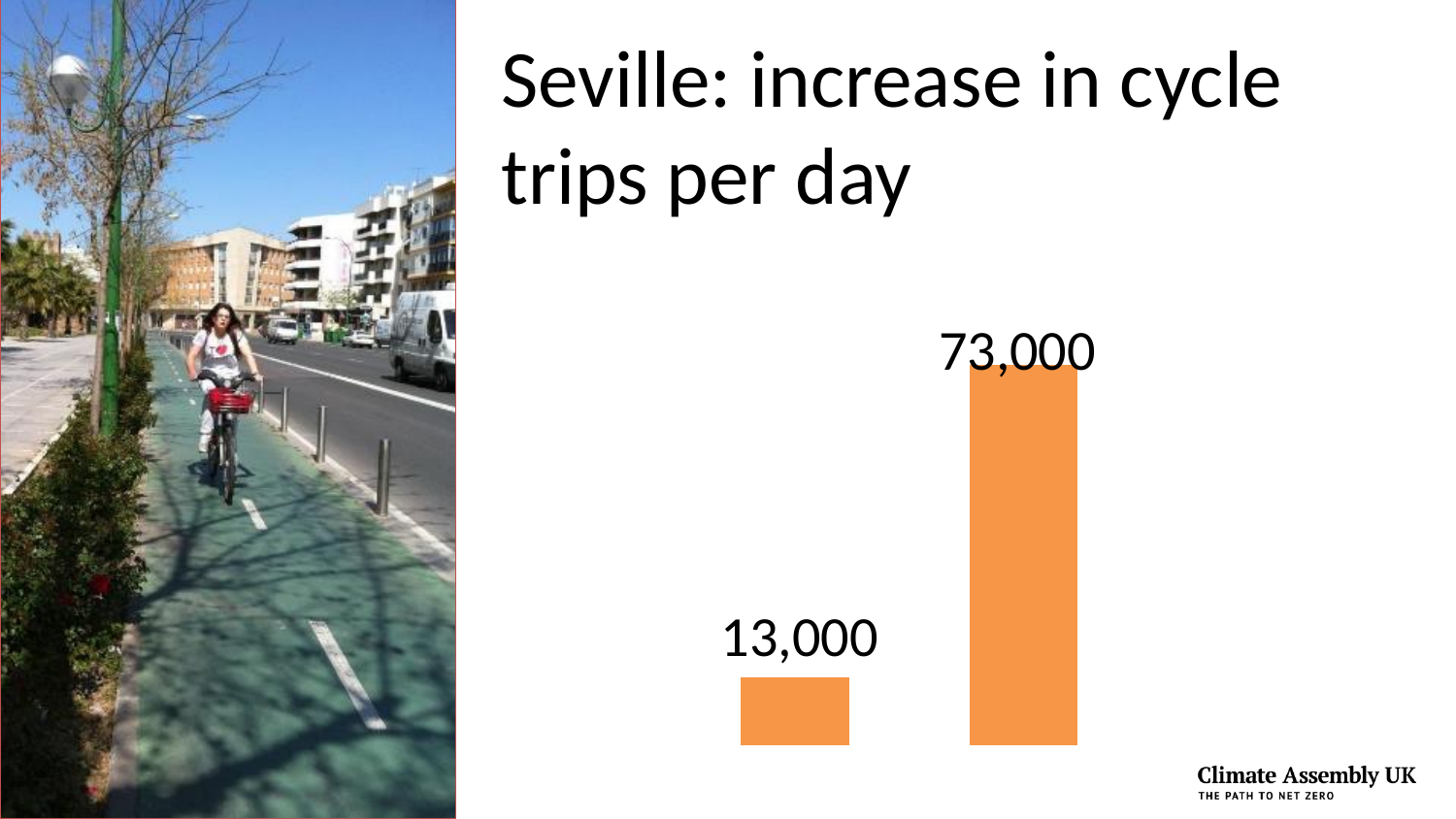
Which bar is taller, the left bar or the right bar? the right bar What is the title of the slide containing the chart? Seville: increase in cycle trips per day What kind of chart is shown on the slide? bar chart What is the value shown on the right bar of the chart? 73,000 Do the values rise or fall from the left bar to the right bar? rise How many bars are plotted in the chart? 2 What is the lowest value shown in the chart? 13,000 What is the difference between the two bar values in the chart? 60,000 What colour are the bars in the chart? orange What is the highest value shown in the chart? 73,000 What is the value shown on the left bar of the chart? 13,000